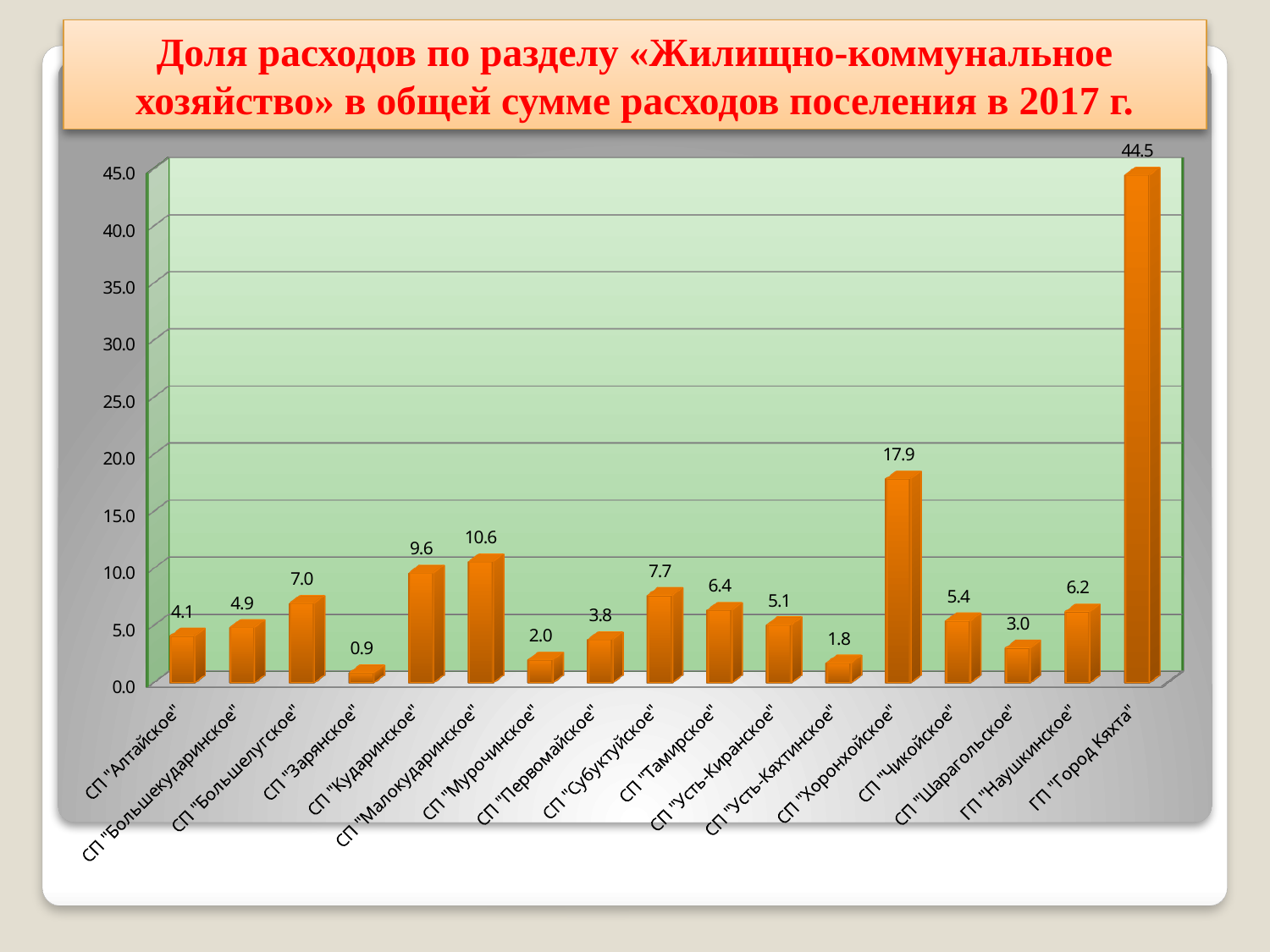
How many categories are shown on the x axis? 17 Is the value for СП "Хоронхойское" greater or less than 15.0? greater What is the value for СП "Кударинское"? 9.6 What is the value for СП "Зарянское"? 0.9 What kind of chart is shown on the slide? bar chart What is the difference between the values for ГП "Город Кяхта" and СП "Хоронхойское"? 26.6 What is the value for СП "Хоронхойское"? 17.9 Which is larger, the value for СП "Малокударинское" or СП "Субуктуйское"? СП "Малокударинское" Which category has the lowest value? СП "Зарянское" Which category has the highest value? ГП "Город Кяхта" What is the difference between the values for СП "Большелугское" and СП "Алтайское"? 2.9 What is the value for ГП "Наушкинское"? 6.2